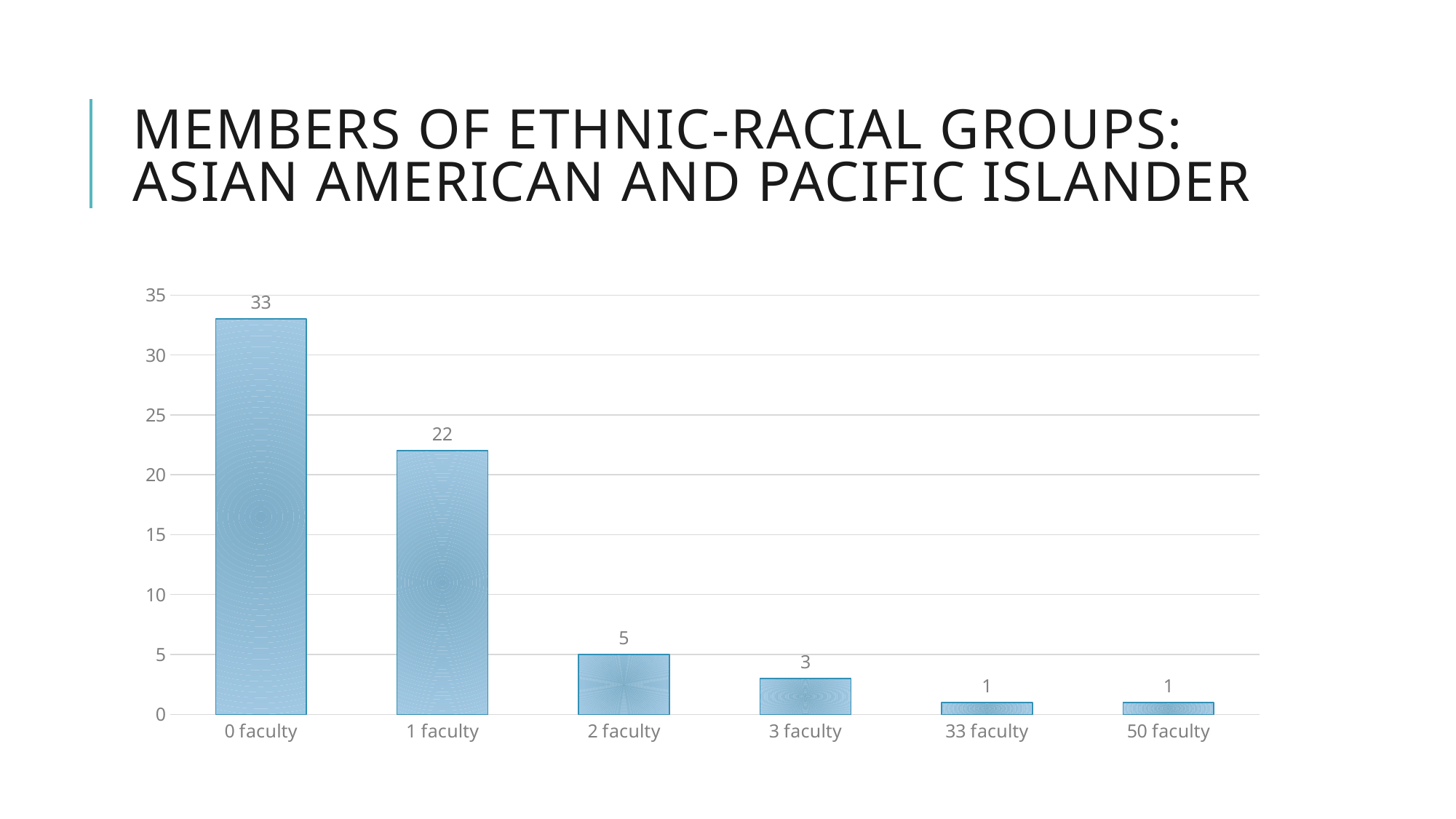
How many categories are shown on the x axis? 6 Is the value for "1 faculty" greater or less than 20? greater What is the title of the slide? Members of Ethnic-Racial Groups: Asian American and Pacific Islander What kind of chart is shown on the slide? Bar chart Do the values rise or fall moving from left to right along the x axis? Fall Which is larger, the value for "2 faculty" or the value for "3 faculty"? 2 faculty Which category has the highest value? 0 faculty What is the value for the "1 faculty" category? 22 What is the value for the "2 faculty" category? 5 What is the difference between the values for "0 faculty" and "1 faculty"? 11 What is the value for the "3 faculty" category? 3 What is the value for the "0 faculty" category? 33